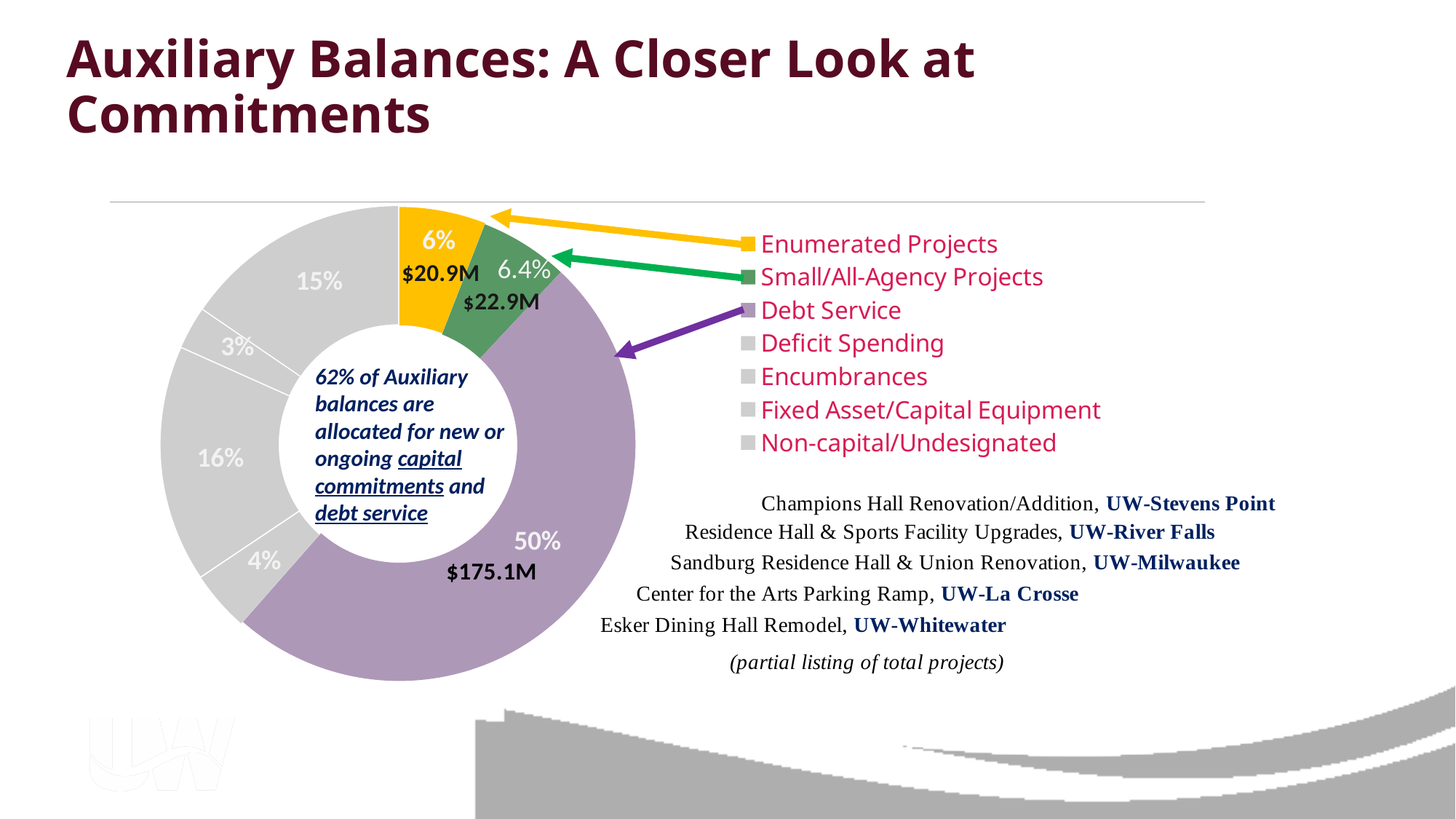
Which is larger, the Enumerated Projects slice or the Small/All-Agency Projects slice? Small/All-Agency Projects What percentage is shown for Enumerated Projects? 6% What kind of chart is shown on the slide? Pie chart (donut) What is the difference in dollars between Debt Service and Small/All-Agency Projects? $152.2M How many categories does the legend list? 7 What percentage is shown for Small/All-Agency Projects? 6.4% Which category has the largest slice of the chart? Debt Service What dollar amount is shown for the Debt Service slice? $175.1M What is the smallest percentage labelled on the chart? 3% What dollar amount is shown for Enumerated Projects? $20.9M What percentage of auxiliary balances is allocated to Debt Service? 50% What dollar amount is shown for Small/All-Agency Projects? $22.9M